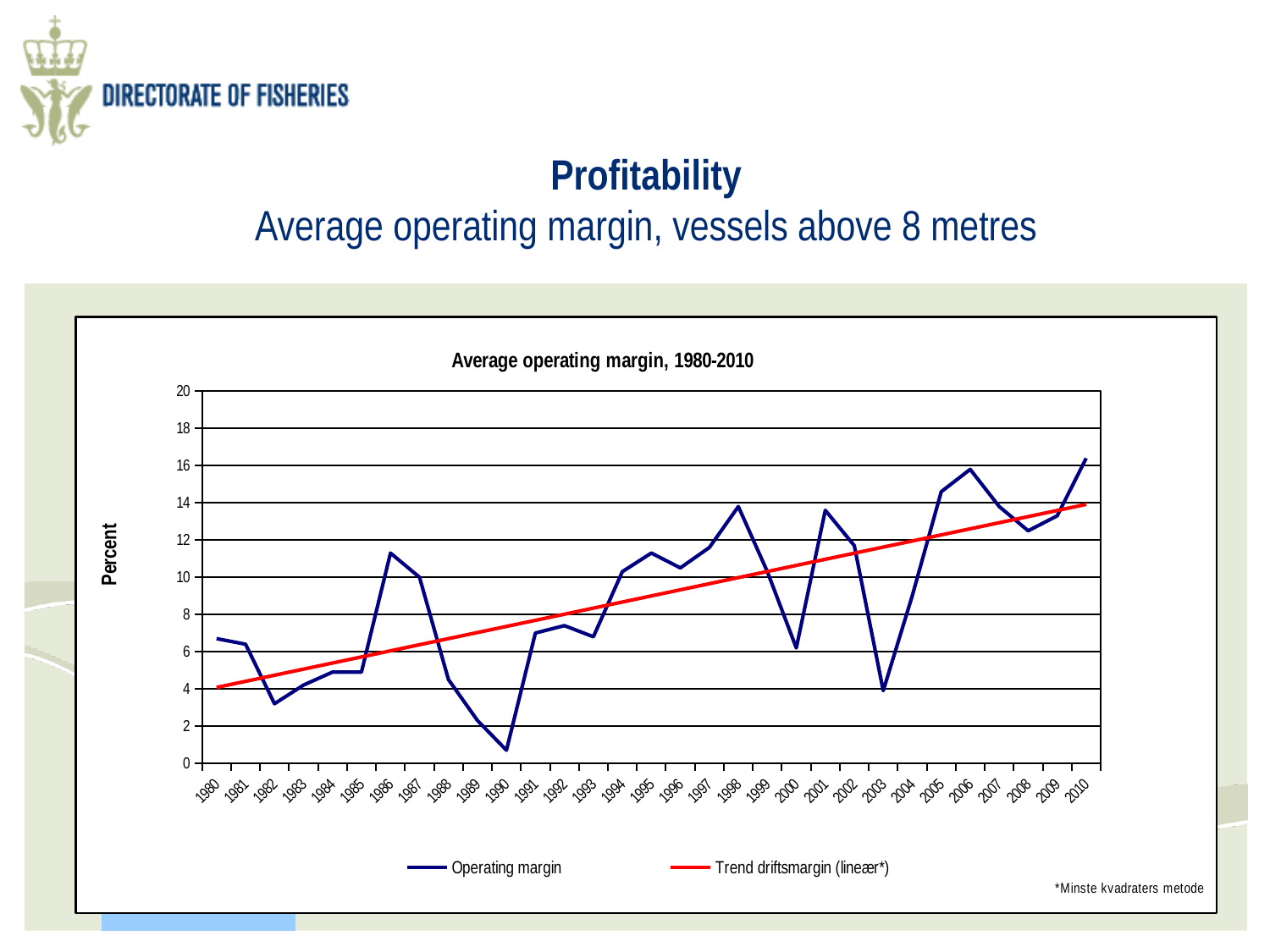
Which year has the larger operating margin, 1986 or 1982? 1986 In which year is the operating margin highest? 2010 What is the label of the y axis? Percent How many series does the chart legend list? 2 What is the title of the chart? Average operating margin, 1980-2010 In which year is the operating margin lowest? 1990 Is the operating margin for 2003 greater or less than 6? less What kind of chart is shown on the slide? line chart How many years are plotted along the x axis? 31 Is the operating margin for 2006 greater or less than 14? greater Is the operating margin for 1990 greater or less than 2? less Does the red trend line rise or fall from 1980 to 2010? rise